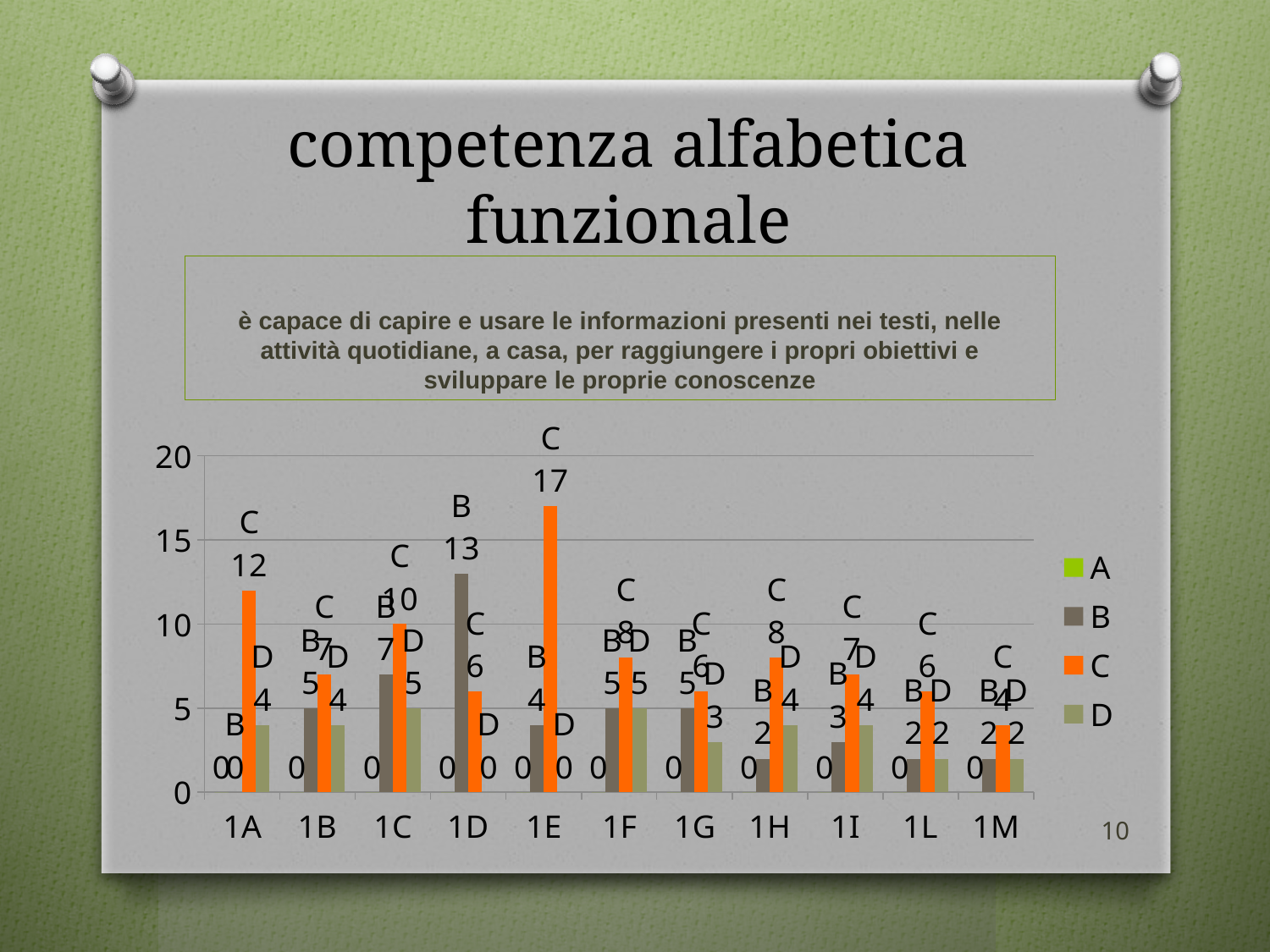
What is the value of series A for category 1H? 0 What is the value of series D for category 1C? 5 How many series does the legend list? 4 Which category has the highest value for series C? 1E What is the value of series C for category 1E? 17 What is the value of series B for category 1D? 13 What is the value of series C for category 1A? 12 What kind of chart is shown on the slide? bar chart Which category has the highest value for series B? 1D What is the difference between the C value and the B value for category 1E? 13 How many categories are shown on the x axis? 11 Which is larger for category 1C: the value of series B or series C? C